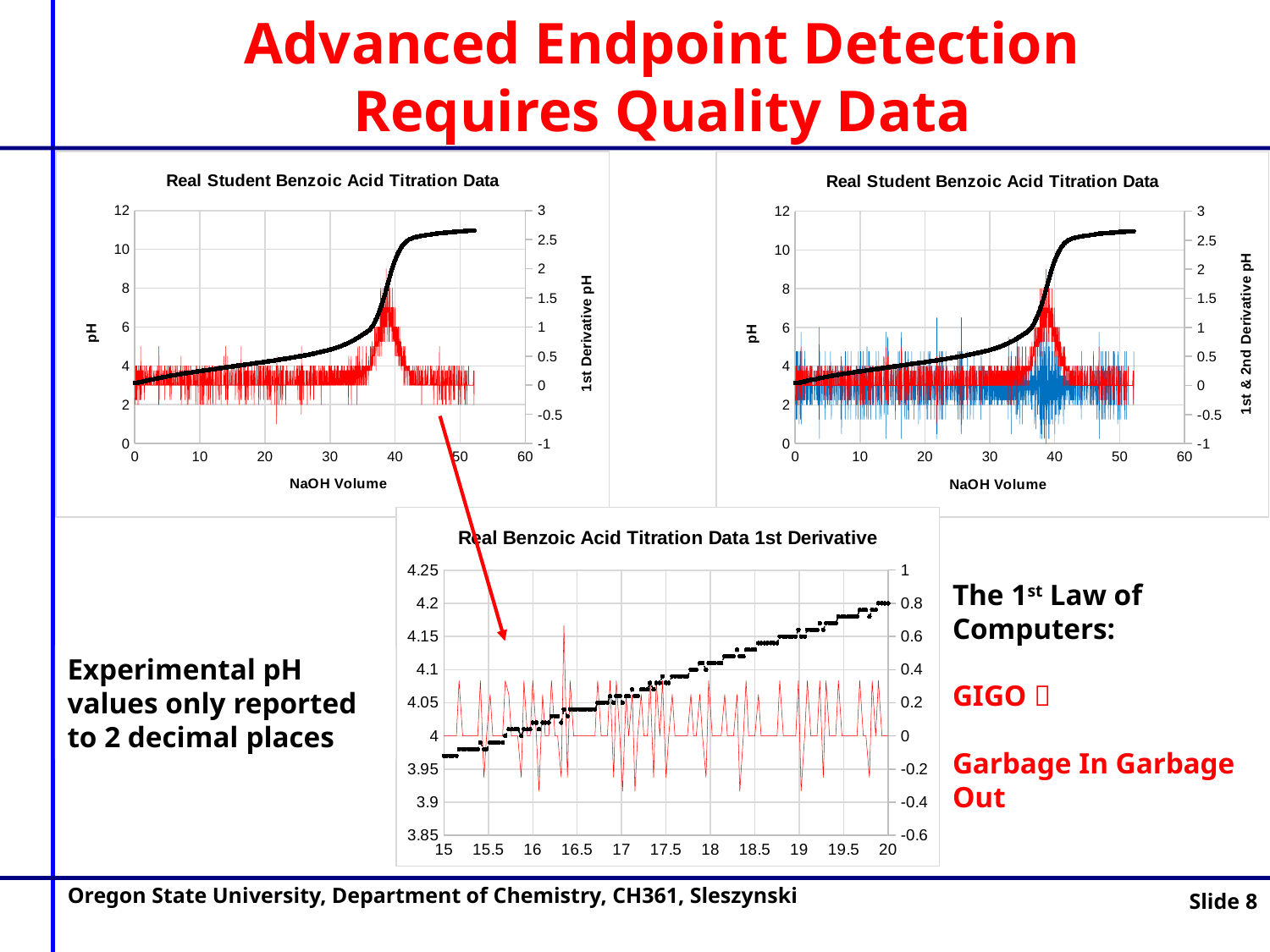
What is the title of the bottom chart? Real Benzoic Acid Titration Data 1st Derivative What is the label of the right-hand vertical axis on the top-right chart? 1st & 2nd Derivative pH In the bottom chart, is the pH value at x = 15 greater or less than 4? less In the bottom chart, do the black pH points rise or fall as the x-axis value goes from 15 to 20? rise In the top-left chart, is the pH value at NaOH Volume 50 greater or less than 10? greater What kind of chart is the top-left chart titled 'Real Student Benzoic Acid Titration Data'? line chart In the top-left chart, does the pH rise or fall as NaOH Volume increases? rises In the top-right chart, is the pH value at NaOH Volume 45 greater or less than 8? greater How many charts are shown on the slide? 3